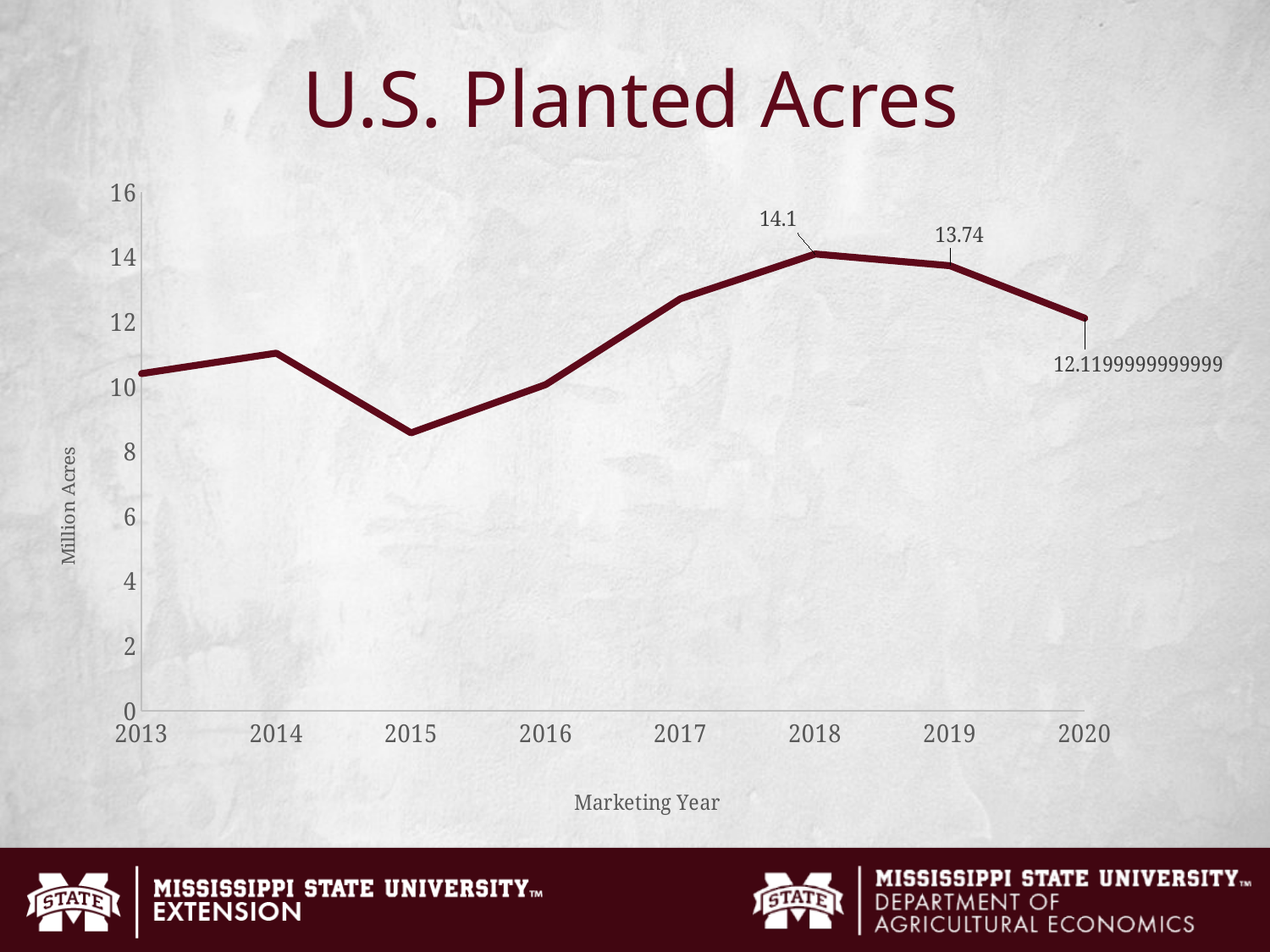
Which year has the highest planted acres? 2018 What is the data label shown for 2020? 12.1199999999999 Is the value for 2015 greater or less than 10? less How many years are plotted on the x axis? 8 Which year has the lowest planted acres? 2015 Which year has the larger value, 2018 or 2019? 2018 What is the value for 2019? 13.74 What is the difference between the values for 2018 and 2019? 0.36 What is the value for 2018? 14.1 Do the values rise or fall from 2018 to 2020? fall Is the value for 2017 greater or less than 12? greater What kind of chart is shown? line chart